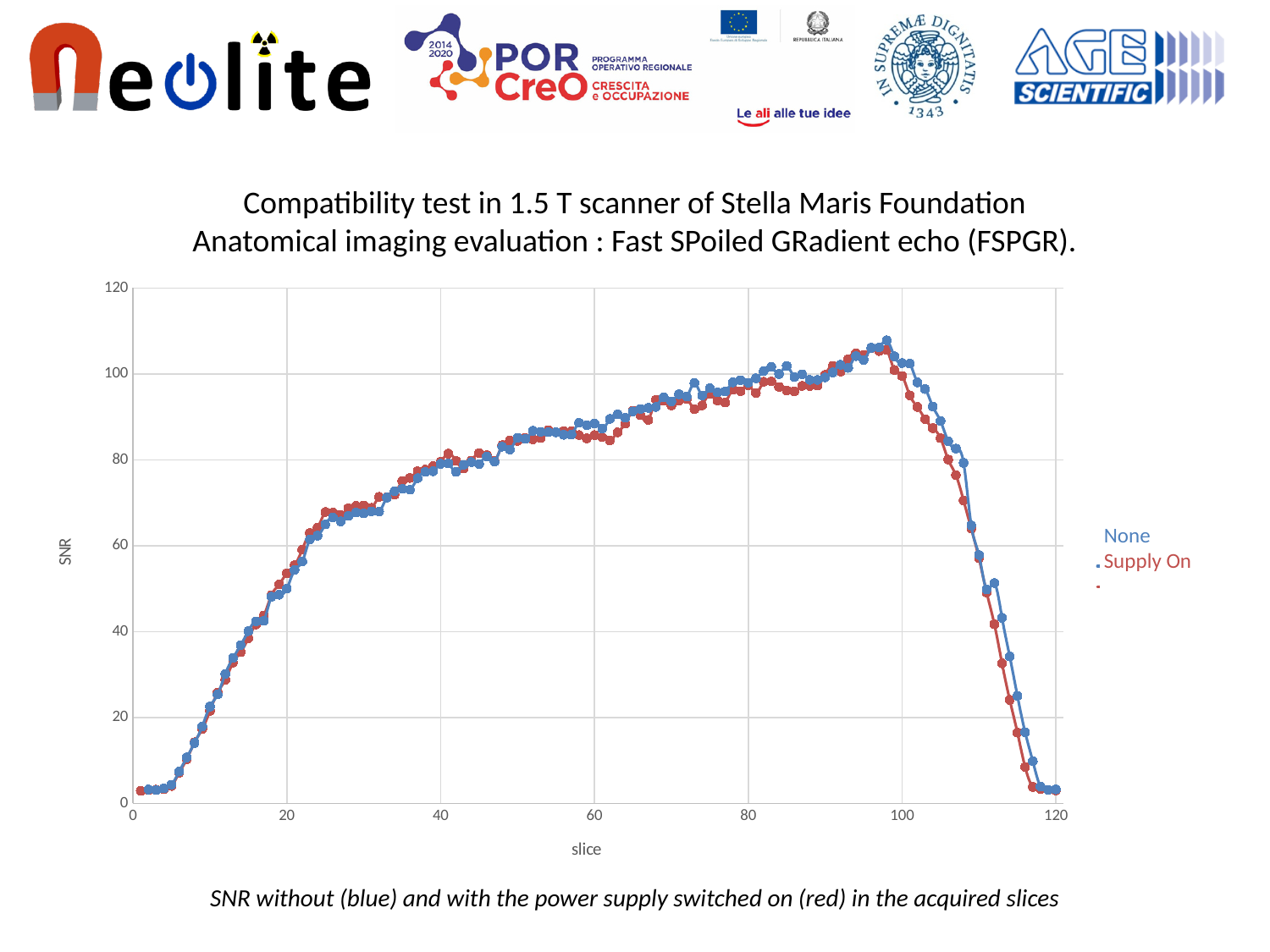
Do the SNR values rise or fall as the slice number increases from 100 to 120? fall Do the SNR values rise or fall as the slice number increases from 0 to 60? rise Is the SNR value for the Supply On series at slice 110 greater or less than 80? less What is the highest tick value shown on the SNR axis? 120 What kind of chart is shown on the slide? scatter chart What is the label of the vertical axis? SNR Near slice 115, which series shows the higher SNR, None or Supply On? None What are the two series named in the legend? None and Supply On Is the SNR value for the Supply On series at slice 60 greater or less than 80? greater Is the SNR value for the None series at slice 20 greater or less than 40? greater How many series does the legend list? 2